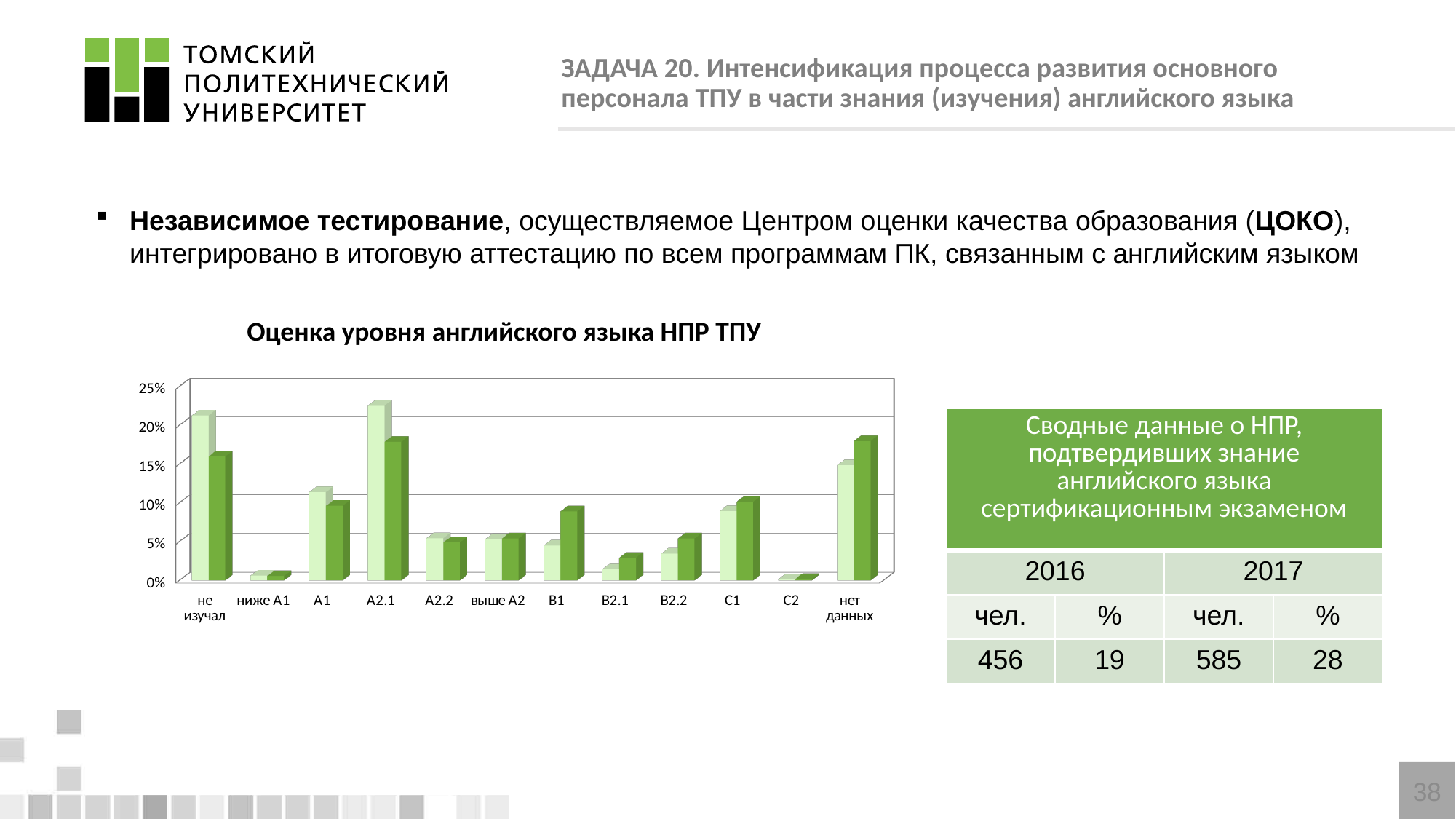
Is the light green bar for A1 greater or less than 10%? greater Is the light green bar for "не изучал" greater or less than 20%? greater How many categories are shown along the x axis of the chart? 12 Is the dark green bar for "не изучал" greater or less than 15%? greater For the category "нет данных", which bar is taller: the light green or the dark green? dark green Which is larger: the light green bar for "не изучал" or the light green bar for A1? не изучал What kind of chart is shown on the slide? bar chart Which is larger: the dark green bar for B1 or the dark green bar for B2.1? B1 What is the title of the chart on the slide? Оценка уровня английского языка НПР ТПУ